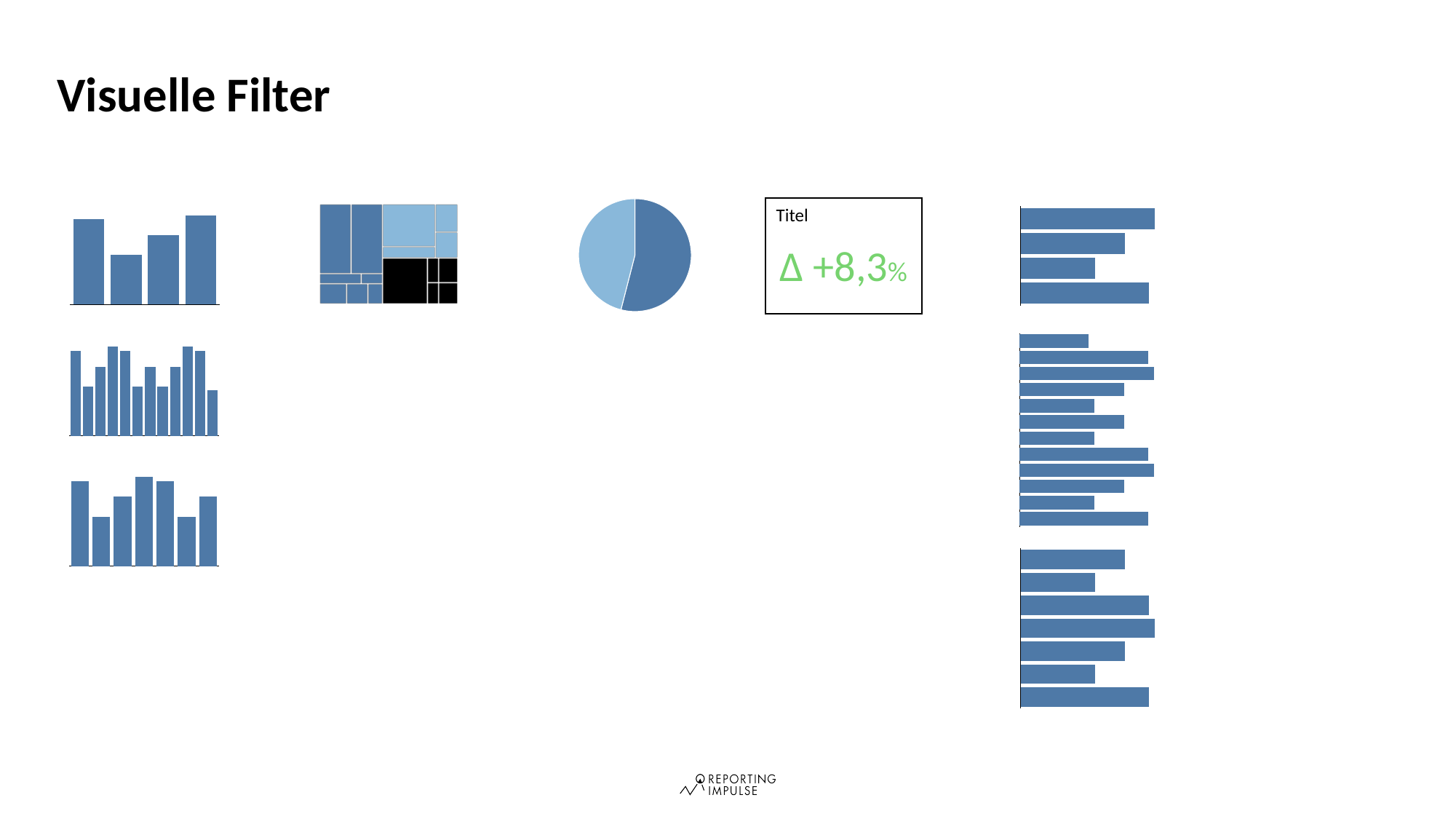
What kind of chart is the circular chart in the upper middle of the slide? pie chart What is the title of the boxed KPI tile next to the pie chart? Titel What kind of chart is shown at the top left of the slide? bar chart In the topmost horizontal bar chart on the right, which bar is the shortest? the third bar What value is shown in the KPI box labelled 'Titel'? Δ +8,3% In the top-left bar chart, which bar is the tallest? the fourth (rightmost) bar What kind of charts are shown on the right side of the slide? bar chart What is the title of the slide? Visuelle Filter How many slices does the pie chart have? 2 How many bars does the top-left bar chart have? 4 In the top-left bar chart, which bar is the shortest? the second bar How many bars does the topmost horizontal bar chart on the right have? 4